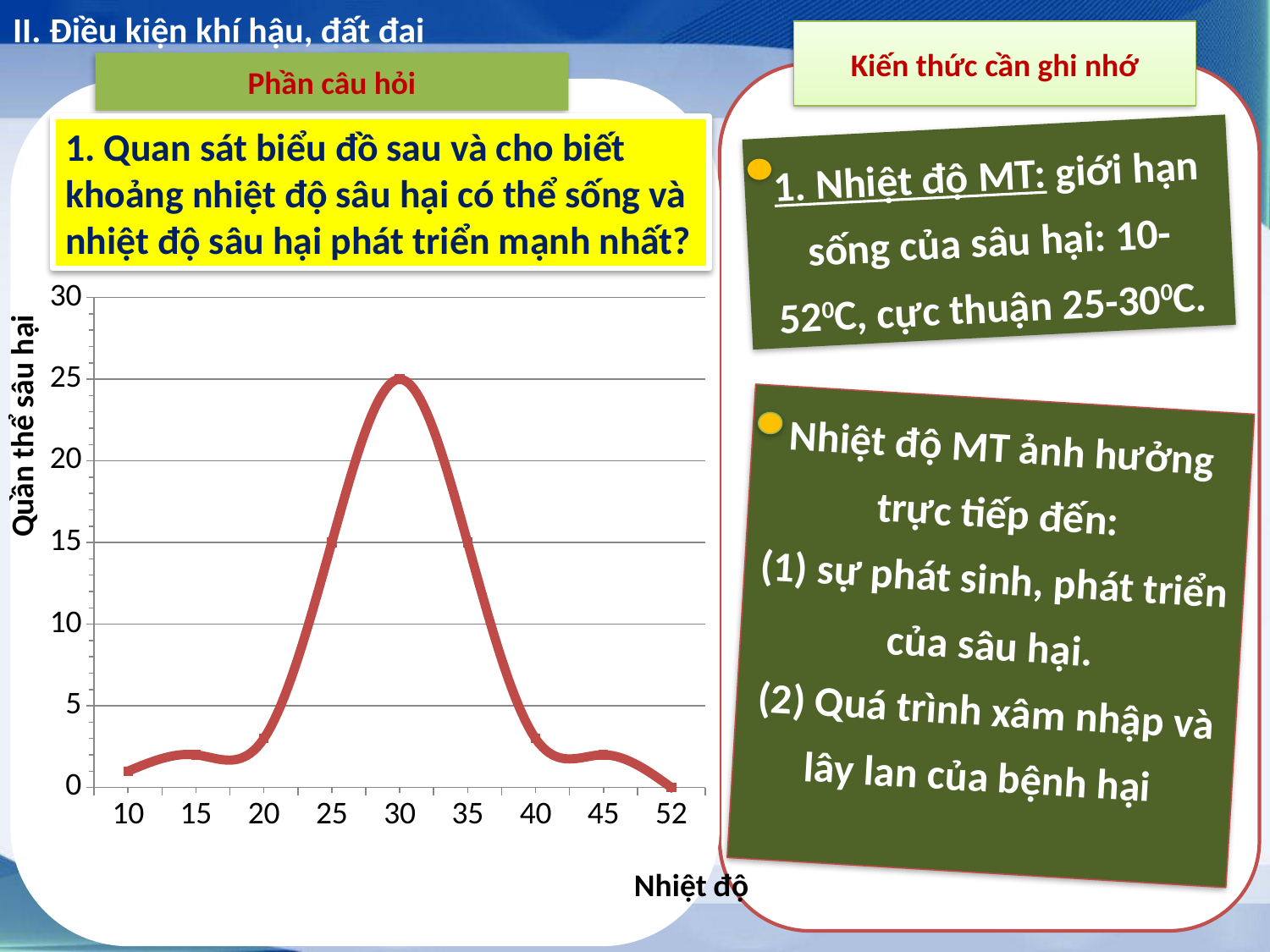
What is the value of Quần thể sâu hại at Nhiệt độ 25? 15 At which Nhiệt độ is Quần thể sâu hại lowest? 52 What is the value of Quần thể sâu hại at Nhiệt độ 35? 15 What is the label of the y axis? Quần thể sâu hại What is the value of Quần thể sâu hại at Nhiệt độ 30? 25 At which Nhiệt độ is Quần thể sâu hại highest? 30 Is the value at Nhiệt độ 20 greater or less than 5? less What is the value of Quần thể sâu hại at Nhiệt độ 52? 0 How many Nhiệt độ points are labelled on the x axis? 9 What is the difference between the value at Nhiệt độ 30 and the value at Nhiệt độ 25? 10 Which is larger, the value at Nhiệt độ 30 or the value at Nhiệt độ 40? 30 What kind of chart is shown on the slide? line chart